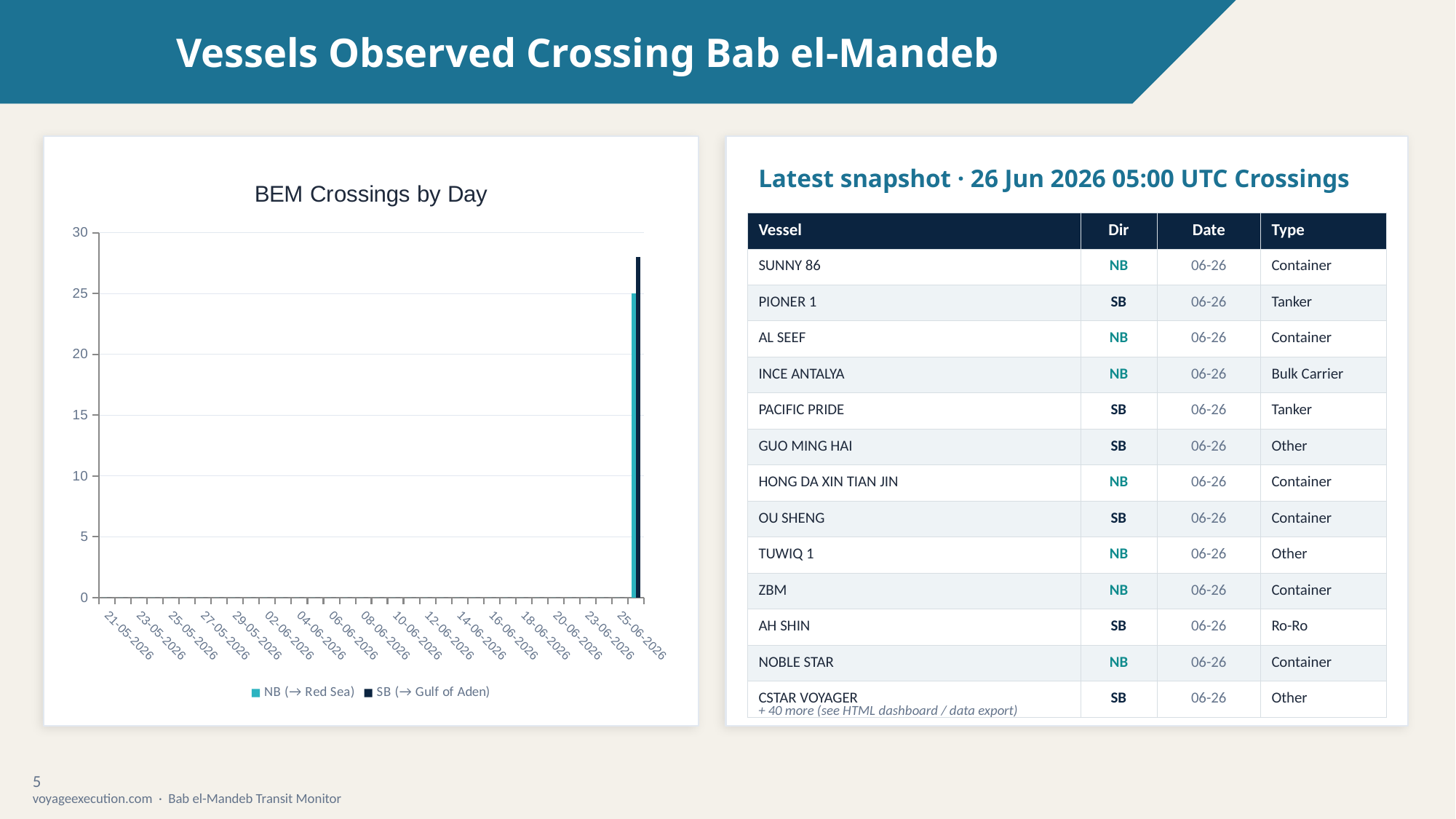
In "BEM Crossings by Day", is the SB (→ Gulf of Aden) bar on the last day greater or less than 30? less In "BEM Crossings by Day", is the SB (→ Gulf of Aden) bar on the last day greater or less than 25? greater In "BEM Crossings by Day", is the NB (→ Red Sea) bar on the last day greater or less than 30? less What is the highest value shown on the y axis of "BEM Crossings by Day"? 30 What kind of chart is "BEM Crossings by Day"? bar chart In "BEM Crossings by Day", which series is shown in dark navy? SB (→ Gulf of Aden) How many series does the legend of "BEM Crossings by Day" list? 2 In "BEM Crossings by Day", do the bars appear across all dates or only at the end of the x axis? only at the end What is the first date label on the x axis of "BEM Crossings by Day"? 21-05-2026 In "BEM Crossings by Day", which series has the taller bar on the last day shown? SB (→ Gulf of Aden) What is the title of the chart on the left of the slide? BEM Crossings by Day